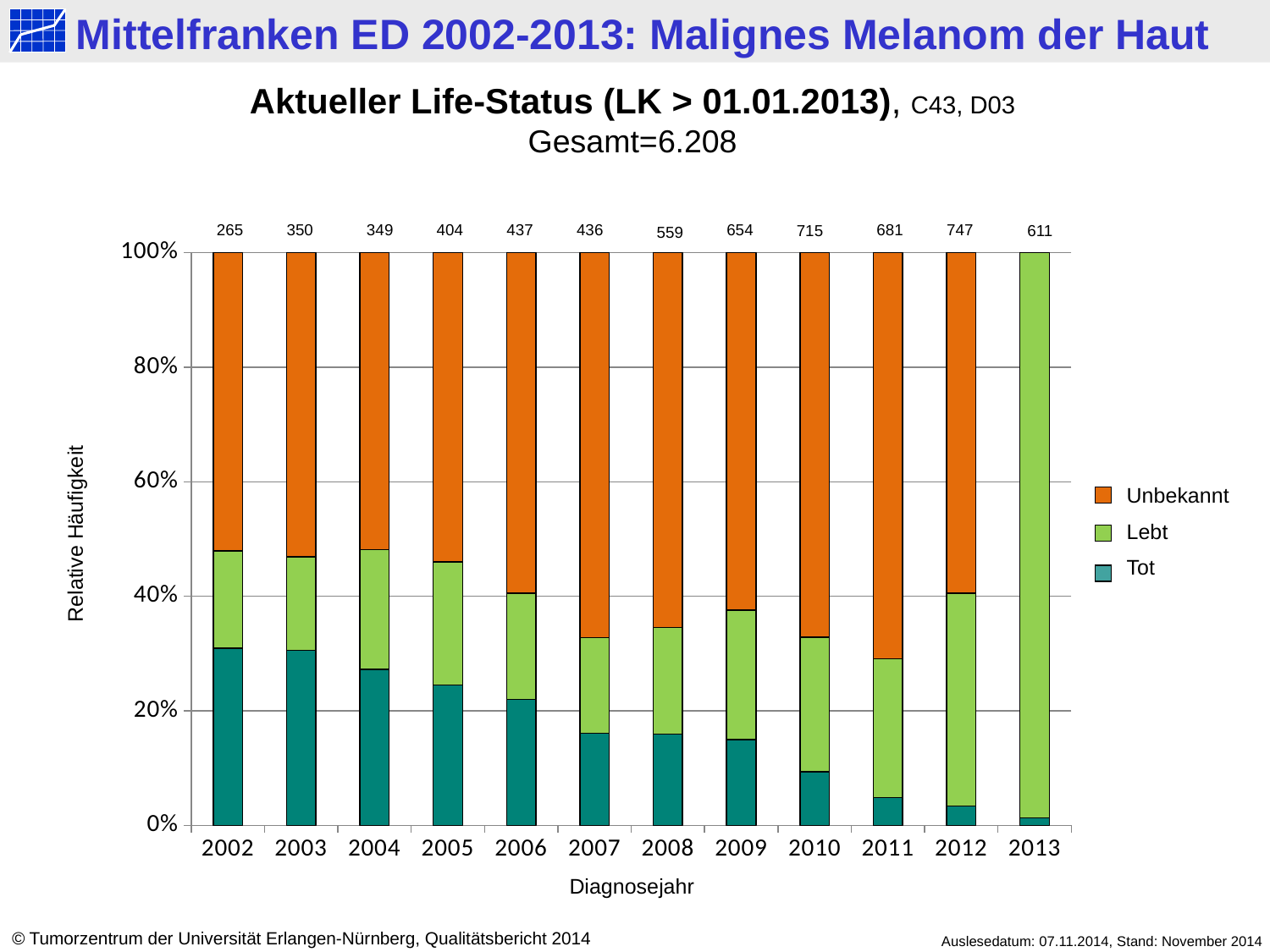
Is the share of 'Tot' in 2013 greater or less than 20%? less What is the difference between the numbers printed above the bars for 2012 and 2002? 482 How many diagnosis years are shown on the x axis? 12 What is the number printed above the bar for 2008? 559 Which year has the larger number printed above its bar, 2010 or 2011? 2010 Which diagnosis year has the highest number printed above its bar? 2012 What is the number printed above the bar for 2002? 265 Which diagnosis year has the lowest number printed above its bar? 2002 Is the share of 'Tot' in 2002 greater or less than 20%? greater Does the share of 'Tot' rise or fall from 2002 to 2013? fall How many series does the legend list? 3 What is the number printed above the bar for 2012? 747